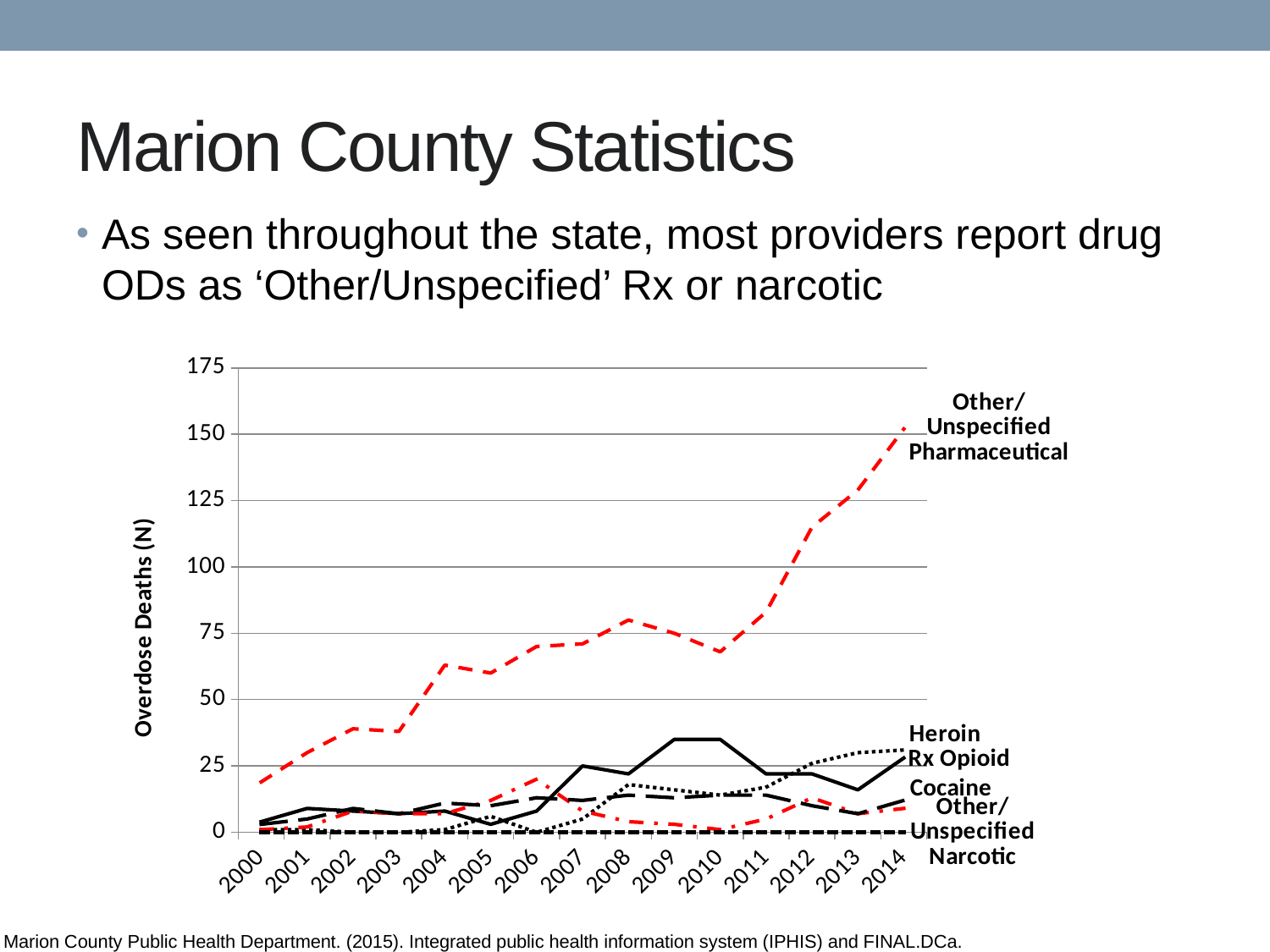
Is the value for Other/Unspecified Pharmaceutical in 2014 greater or less than 125? greater Is the value for Heroin in 2009 greater or less than 25? less In 2014, which is larger: Other/Unspecified Pharmaceutical or Heroin? Other/Unspecified Pharmaceutical Is the value for Other/Unspecified Pharmaceutical in 2008 greater or less than 50? greater Which series has the highest value in 2014? Other/Unspecified Pharmaceutical Does the Other/Unspecified Pharmaceutical series generally rise or fall from 2000 to 2014? rise How many years are shown along the x axis of the chart? 15 In 2009, which is larger: Heroin or Rx Opioid? Rx Opioid What kind of chart is shown on the slide? line chart What is the label of the y axis of the chart? Overdose Deaths (N)